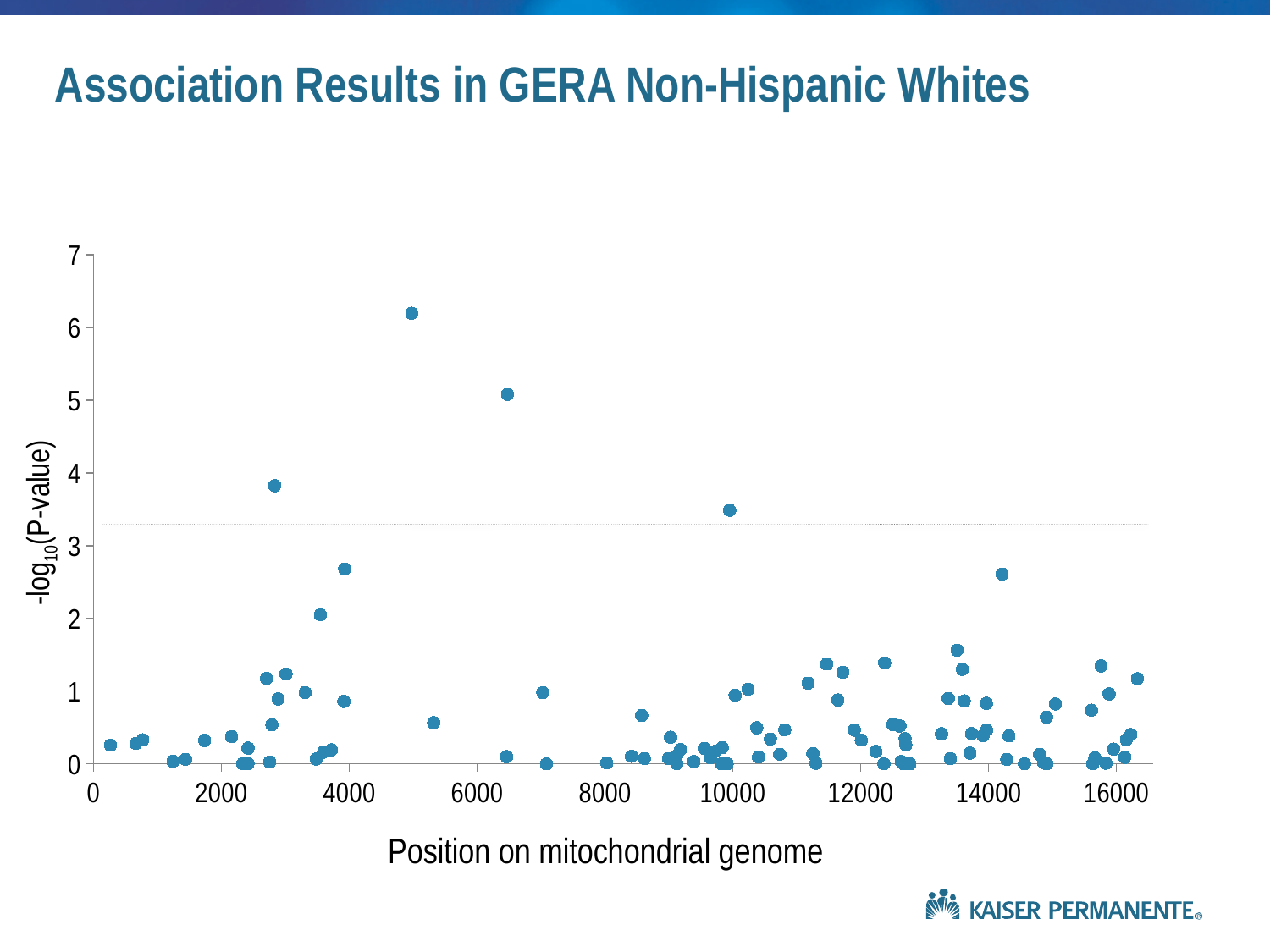
How many points lie above the horizontal dashed line? 4 Is the value of the highest point near position 4000 greater or less than 3? less Is the value of the highest point on the chart greater or less than 6? greater What kind of chart is shown on the slide? scatter chart What is the label of the x axis? Position on mitochondrial genome Is the value of the point near position 2800 that lies above the dashed line greater or less than 4? less How many points have a -log10(P-value) greater than 6? 1 What is the title of the chart? Association Results in GERA Non-Hispanic Whites